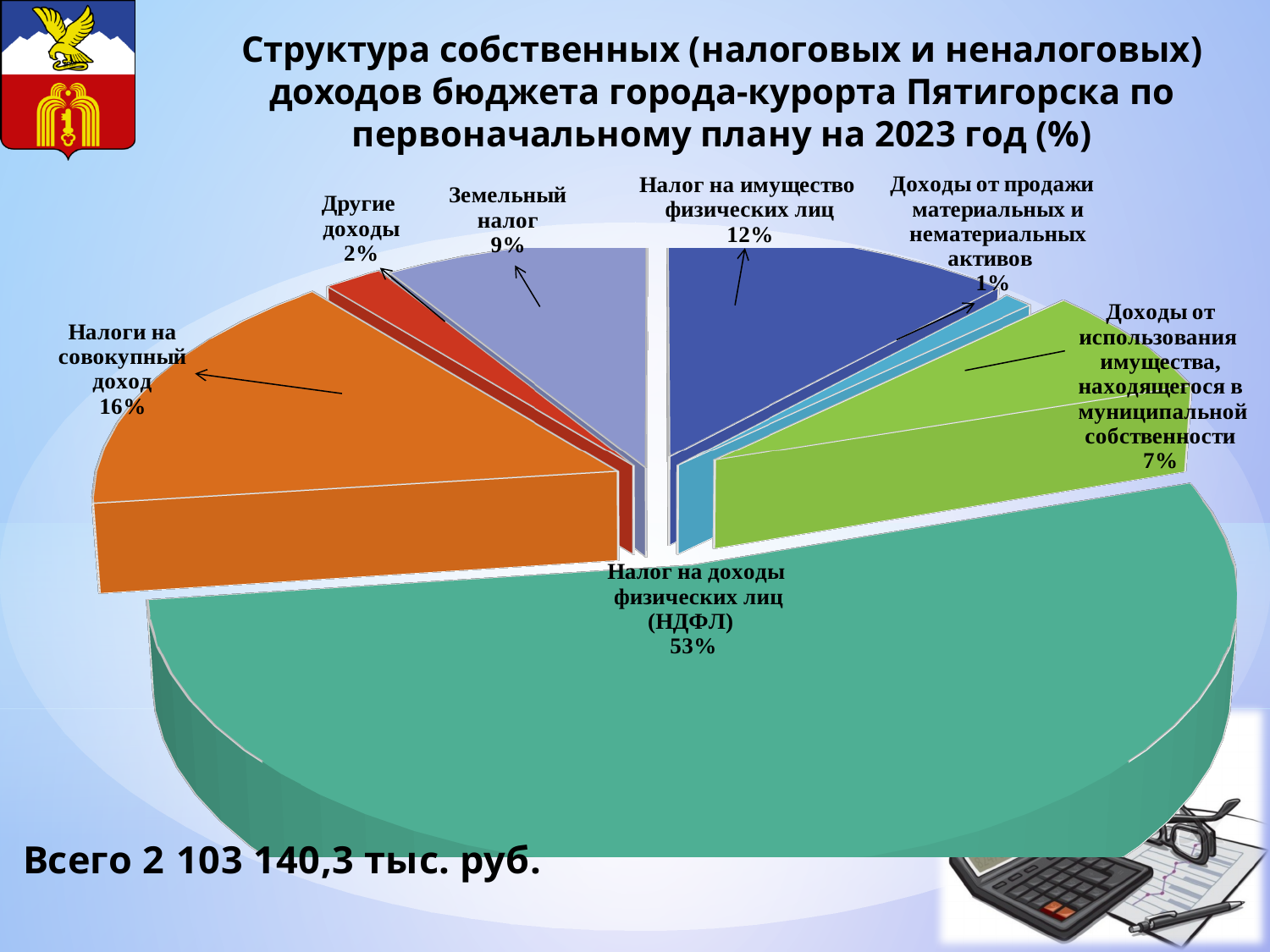
Какую долю составляют доходы от продажи материальных и нематериальных активов? 1% Сколько категорий доходов показано на диаграмме? 7 На сколько процентных пунктов доля налога на имущество физических лиц больше доли земельного налога? 3 Какая общая сумма собственных доходов указана на слайде? 2 103 140,3 тыс. руб. Какая категория доходов имеет наибольшую долю на диаграмме? Налог на доходы физических лиц (НДФЛ) Какую долю составляют налоги на совокупный доход? 16% Что больше: доля налогов на совокупный доход или доля налога на имущество физических лиц? Налоги на совокупный доход Какую долю составляет земельный налог? 9% Какую долю составляют доходы от использования имущества, находящегося в муниципальной собственности? 7% Какую долю составляет налог на доходы физических лиц (НДФЛ) в структуре собственных доходов бюджета? 53% Какой тип диаграммы использован на слайде? Круговая диаграмма Какая категория доходов имеет наименьшую долю на диаграмме? Доходы от продажи материальных и нематериальных активов